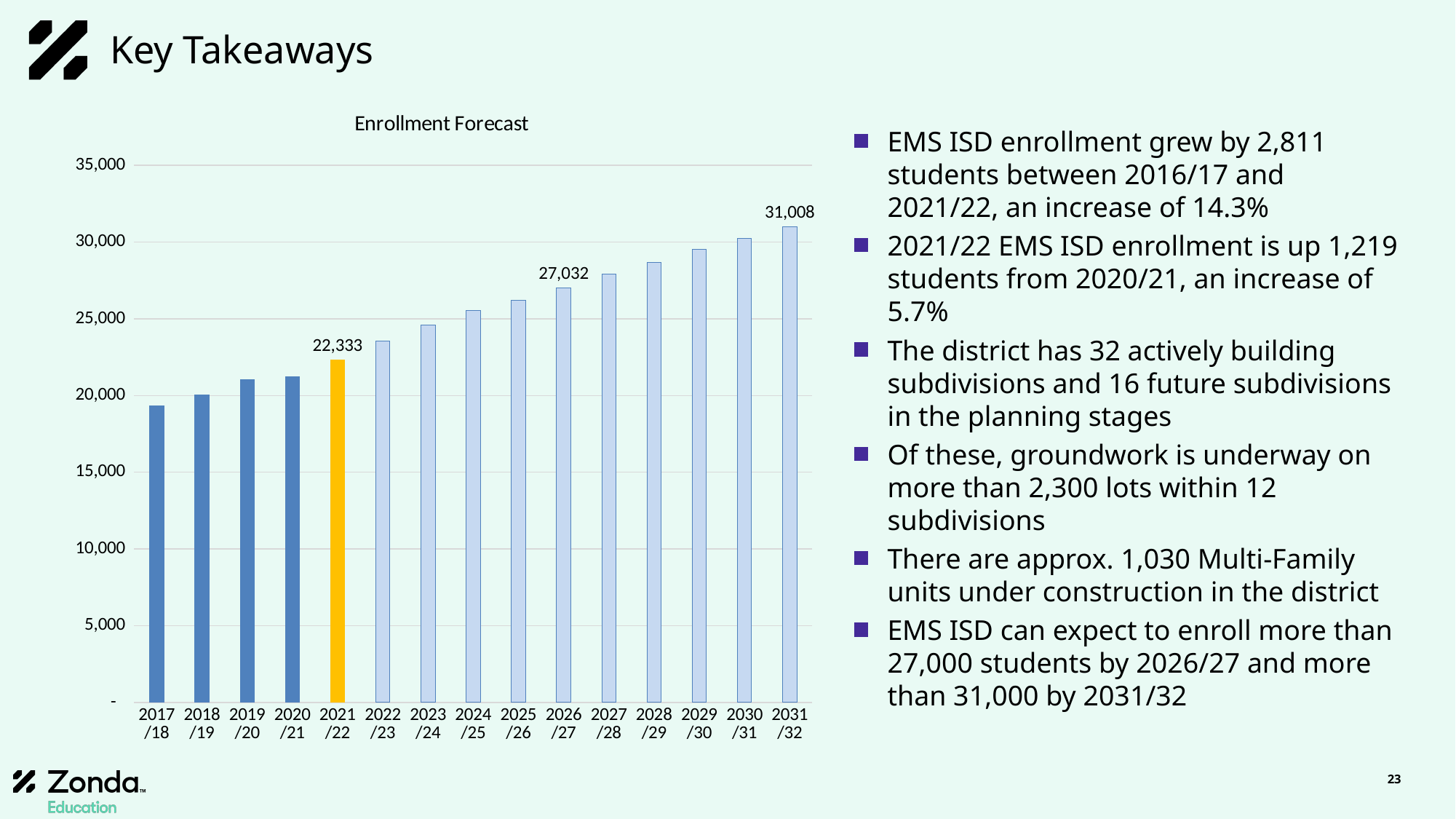
What is the enrollment value shown for 2021/22? 22,333 What is the difference between the enrollment values for 2026/27 and 2021/22? 4,699 What is the enrollment value shown for 2026/27? 27,032 What is the title of the chart? Enrollment Forecast Is the value for 2017/18 greater or less than 20,000? less What is the enrollment value shown for 2031/32? 31,008 Do the enrollment values rise or fall from 2017/18 to 2031/32? rise What type of chart is shown on the slide? bar chart What is the difference between the enrollment values for 2031/32 and 2026/27? 3,976 Which year has the highest enrollment in the chart? 2031/32 Which year has the lowest enrollment in the chart? 2017/18 How many years (bars) are shown in the chart? 15